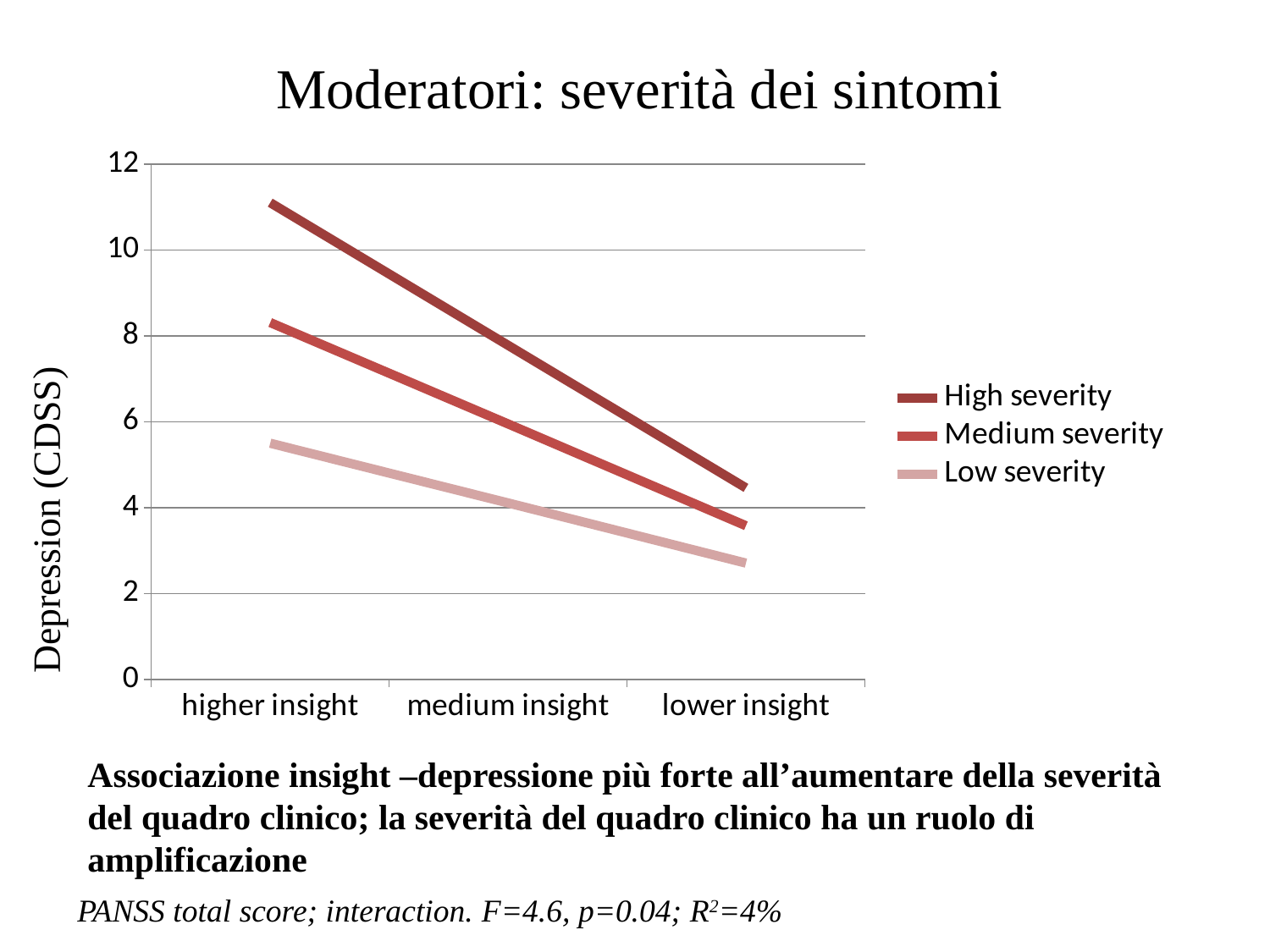
Is the value for Low severity at higher insight greater or less than 6? less At medium insight, which is larger: the value for High severity or the value for Low severity? High severity How many categories are shown on the x axis? 3 Which series has the lowest value at lower insight? Low severity Is the value for High severity at higher insight greater or less than 10? greater Is the value for Low severity at lower insight greater or less than 4? less What kind of chart is shown on the slide? line chart Which series has the highest value at higher insight? High severity What is the label of the y axis? Depression (CDSS) How many series does the legend list? 3 Do the values for High severity rise or fall from higher insight to lower insight? fall